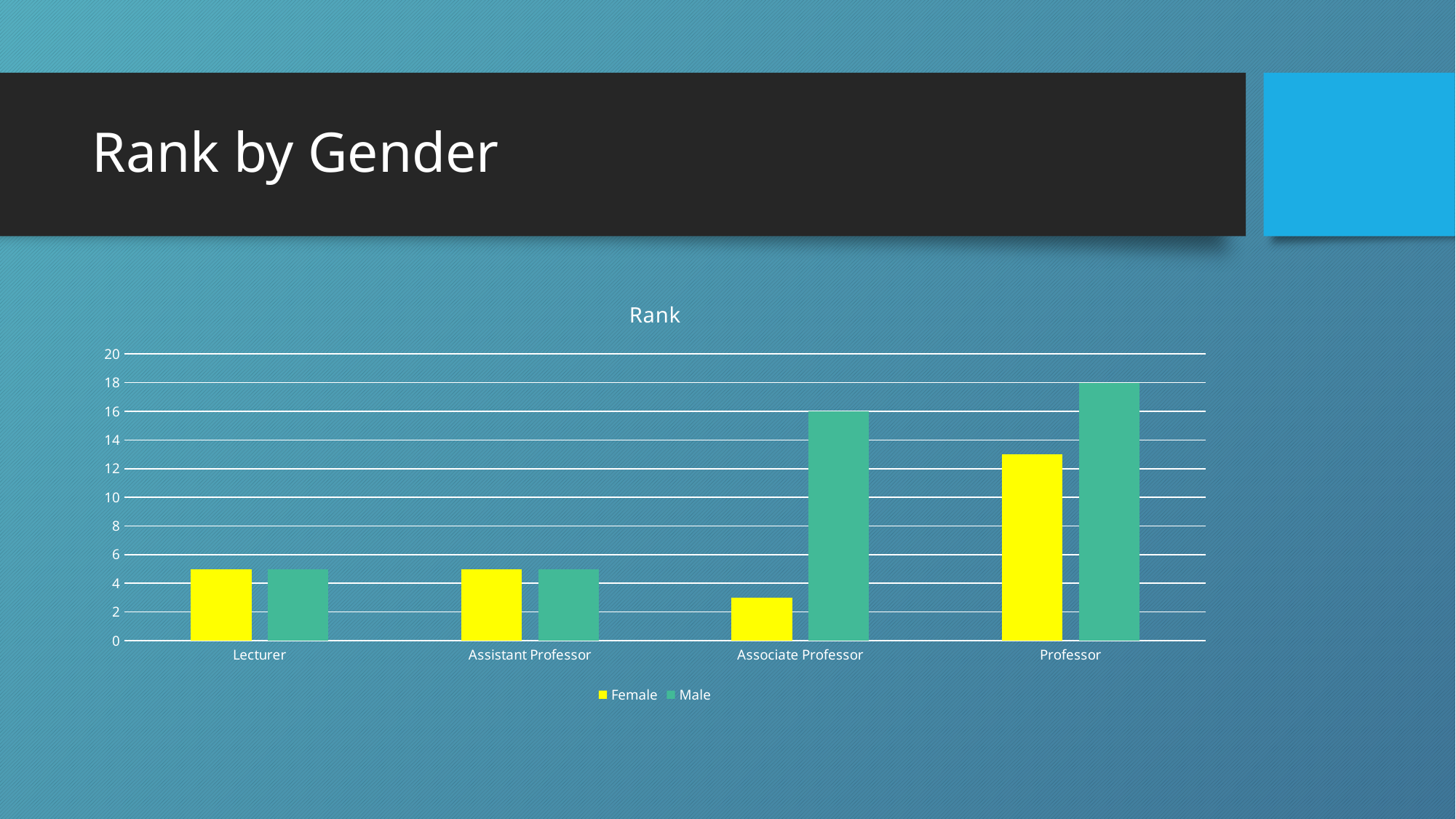
What is the title of the chart? Rank What is the difference between the Male values for Professor and Associate Professor? 2 Is the Female value for Associate Professor greater or less than 4? less How many series does the legend list? 2 How many categories are shown on the x axis? 4 Which category has the highest Male value? Professor What type of chart is shown on the slide? bar chart What is the Male value for Associate Professor? 16 What is the Male value for Professor? 18 Is the Female value for Professor greater or less than 10? greater For Associate Professor, which is larger, the Female value or the Male value? Male Which category has the lowest Female value? Associate Professor